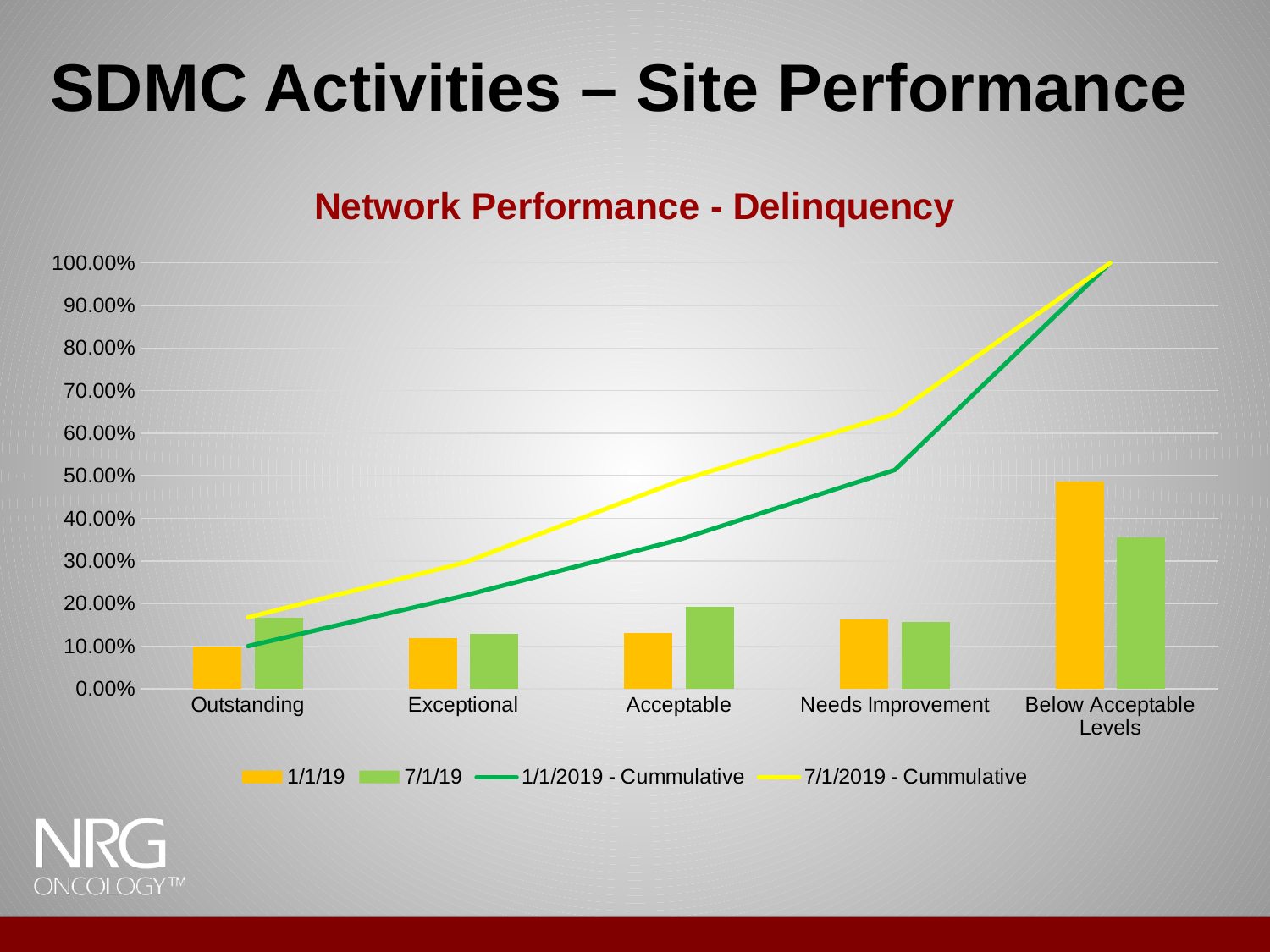
What kind of chart is shown on the slide? bar and line chart What value does the 7/1/2019 - Cummulative line reach at Below Acceptable Levels? 100.00% Is the 1/1/19 value for Below Acceptable Levels greater or less than 40.00%? greater Which category has the highest 7/1/19 bar? Below Acceptable Levels What is the title of the chart? Network Performance - Delinquency For Below Acceptable Levels, which is larger: the 1/1/19 bar or the 7/1/19 bar? 1/1/19 Which category has the highest 1/1/19 bar? Below Acceptable Levels How many series does the chart legend list? 4 For Outstanding, which is larger: the 1/1/19 bar or the 7/1/19 bar? 7/1/19 How many categories are shown on the x axis of the chart? 5 Is the 7/1/19 value for Exceptional greater or less than 20.00%? less Do the cumulative lines rise or fall from Outstanding to Below Acceptable Levels? rise